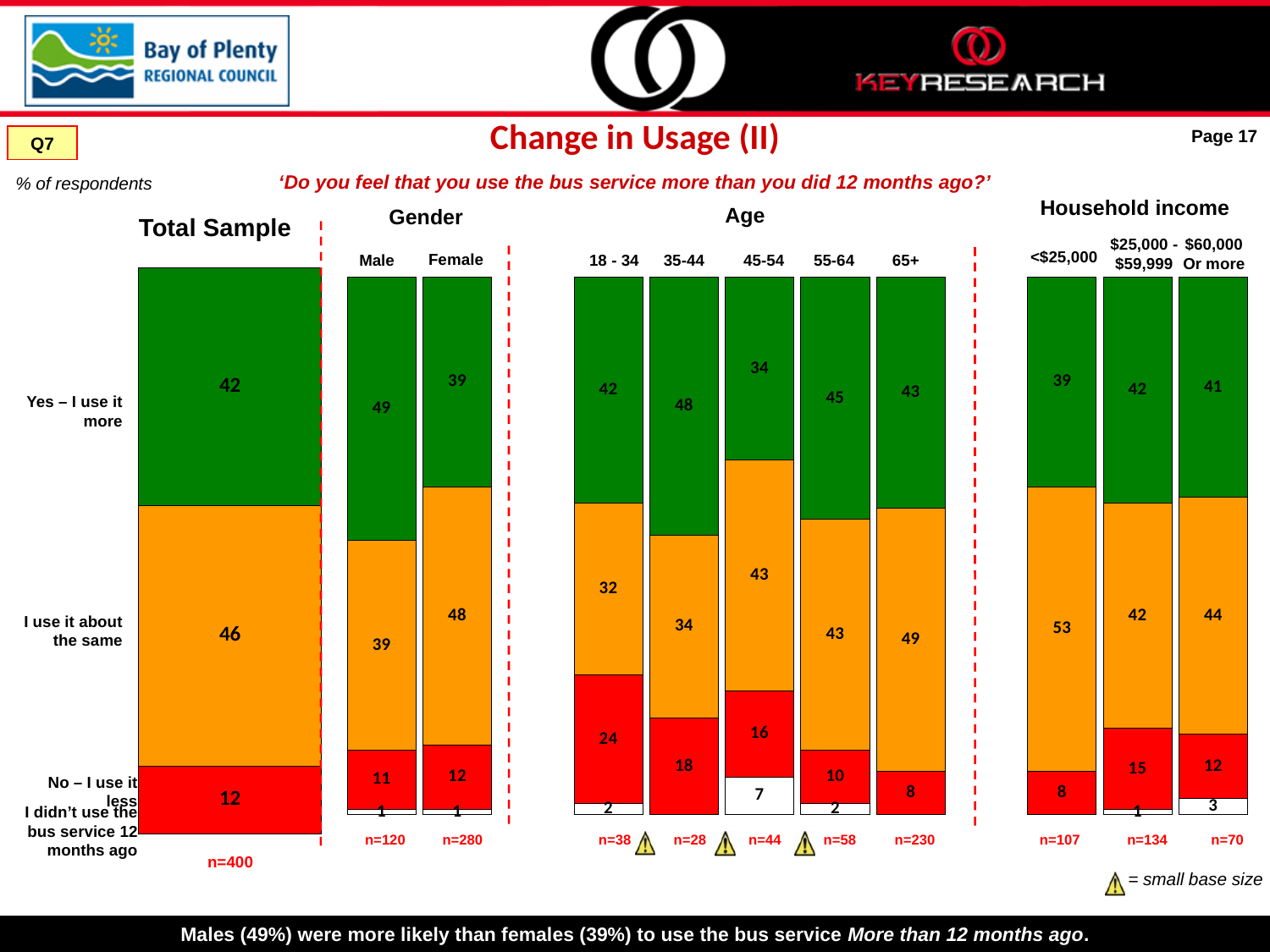
In the Total Sample chart, what percentage of respondents said 'I use it about the same'? 46 In the Gender chart, what is the 'Yes – I use it more' value for Male? 49 In the Age chart, what is the 'I didn't use the bus service 12 months ago' value for the 45-54 group? 7 In the Total Sample chart, what percentage of respondents said 'Yes – I use it more'? 42 How many age groups are shown in the Age chart? 5 In the Age chart, which age group has the lowest 'Yes – I use it more' value? 45-54 What type of chart is used on this slide? Stacked bar chart What is the sample size (n) shown for the Total Sample chart? n=400 In the Gender chart, what is the difference between the Male and Female 'Yes – I use it more' values? 10 In the Age chart, which age group has the highest 'No – I use it less' value? 18 - 34 In the Household income chart, is the 'No – I use it less' value larger for $25,000 - $59,999 or for $60,000 or more? $25,000 - $59,999 In the Household income chart, which income group has the highest 'I use it about the same' value? <$25,000